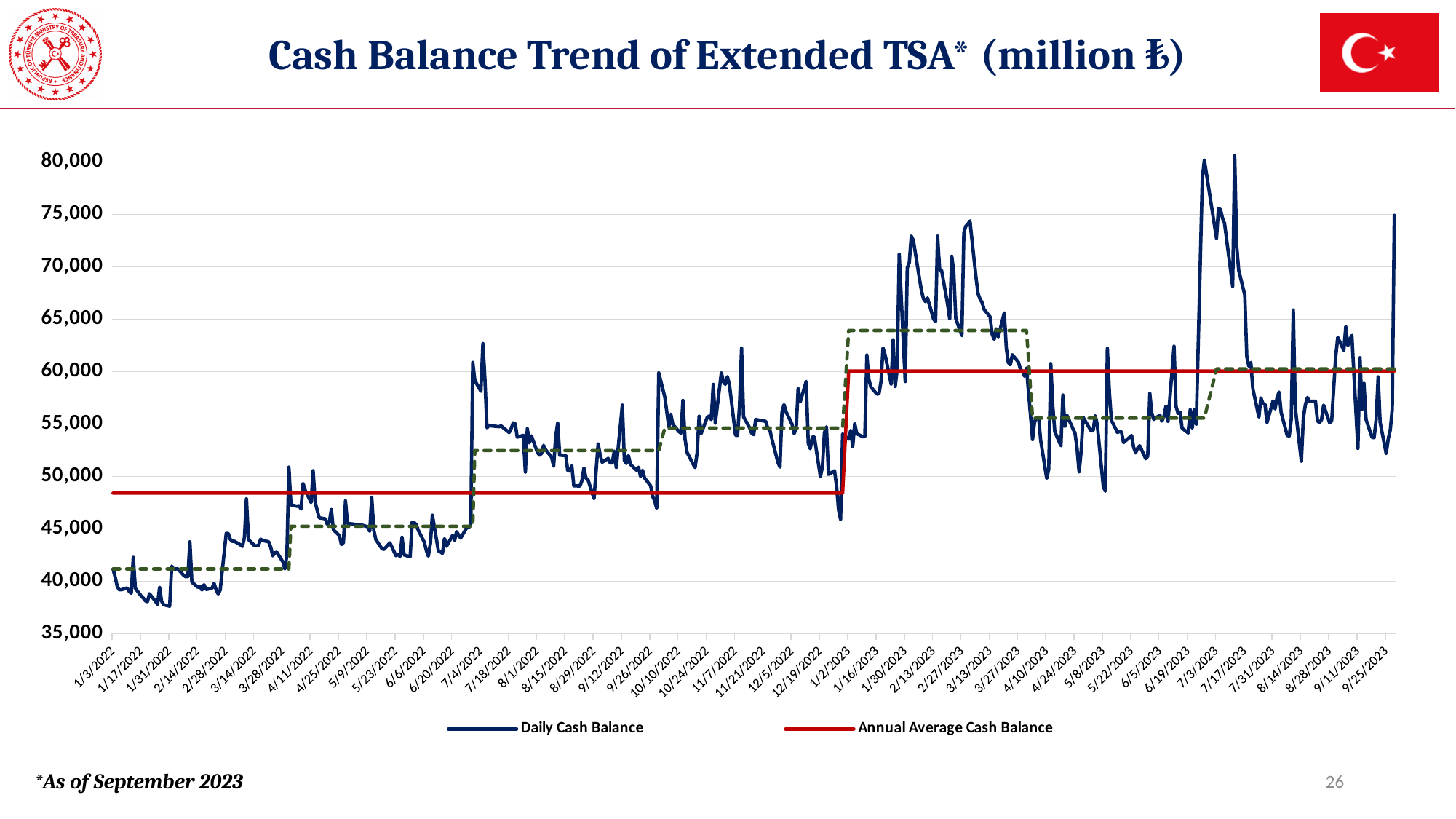
Which colour is used for the Annual Average Cash Balance line? Red Is the Annual Average Cash Balance for 2022 greater or less than 45,000? greater Is the Annual Average Cash Balance for 2022 greater or less than 50,000? less Is the Annual Average Cash Balance for 2023 higher or lower than for 2022? Higher Is the lowest Daily Cash Balance in February 2022 greater or less than 40,000? less At the start of the chart (January 2022), which is larger: the Daily Cash Balance or the Annual Average Cash Balance? Annual Average Cash Balance Does the Daily Cash Balance generally rise or fall from January 2022 to September 2023? Rise What kind of chart is shown on the slide? Line chart How many series does the legend list? 2 What is the title of the chart? Cash Balance Trend of Extended TSA* (million ₺)